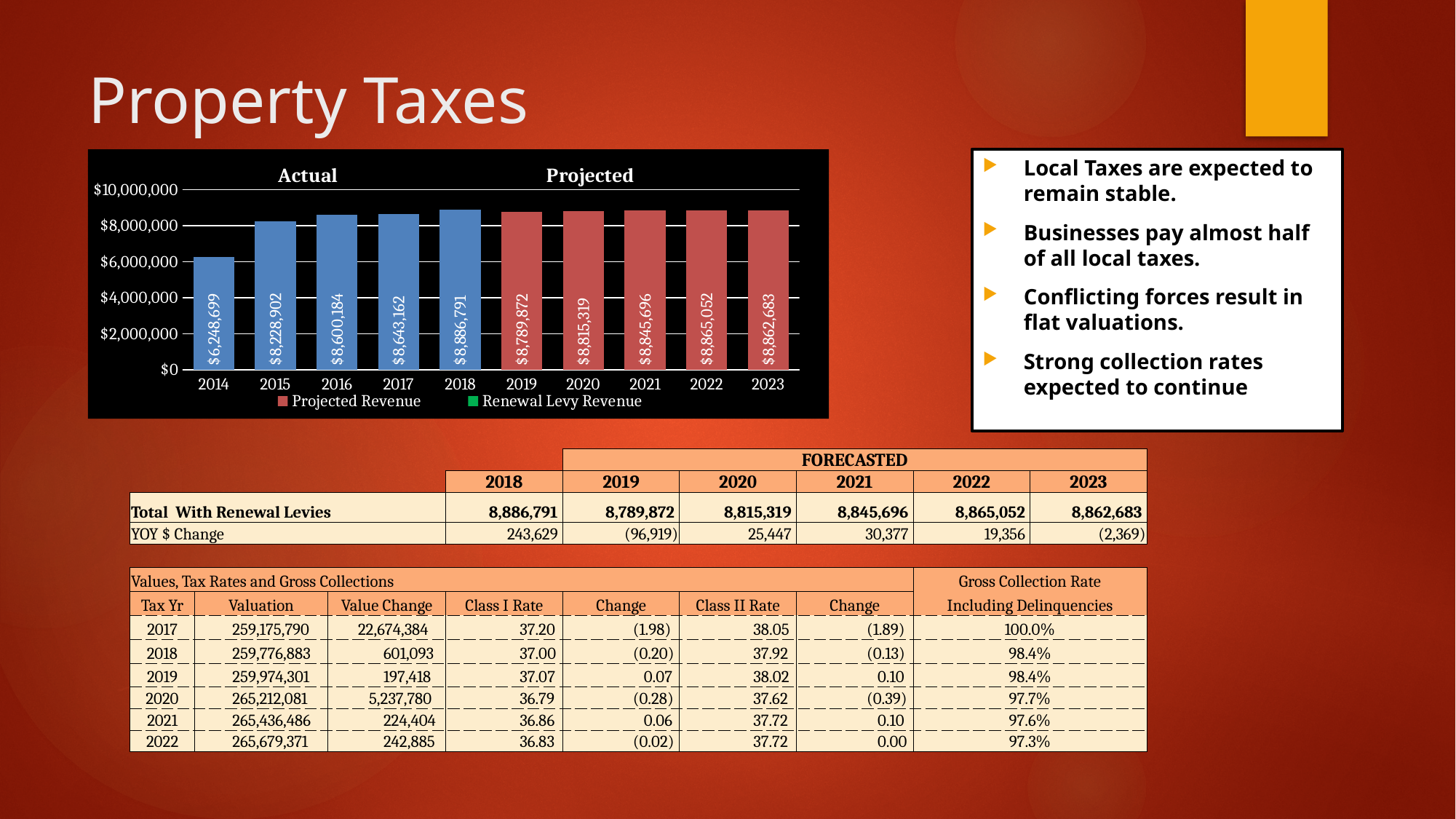
How many series does the legend of the bar chart list? 2 What is the value shown for 2021 in the bar chart? $8,845,696 In the bar chart, which is larger: the value for 2015 or the value for 2016? 2016 Which year has the lowest value in the bar chart? 2014 What is the value shown for 2014 in the bar chart? $6,248,699 What is the difference between the 2018 value and the 2014 value in the bar chart? $2,638,092 Is the value for 2014 in the bar chart greater or less than $8,000,000? less Do the values in the bar chart rise or fall from 2014 to 2018? rise What kind of chart is shown on the slide? bar chart How many years are shown on the x axis of the bar chart? 10 Which year has the highest value in the bar chart? 2018 What is the difference between the 2018 value and the 2019 value in the bar chart? $96,919